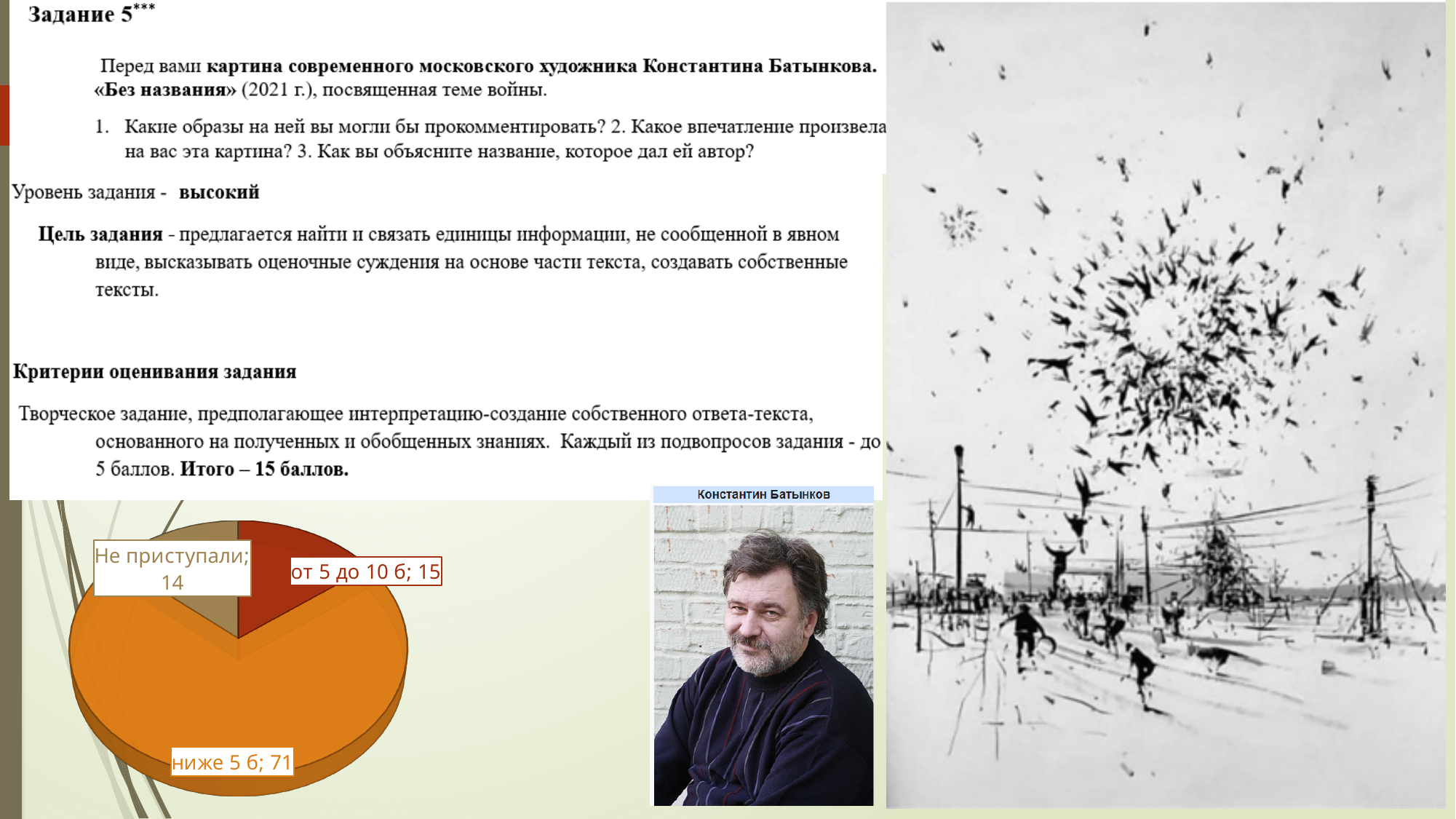
How many slices does the pie chart have? 3 What is the total of all slices in the pie chart? 100 Which slice of the pie chart has the smallest value? Не приступали What kind of chart is shown at the bottom left of the slide? pie chart What colour is the "ниже 5 б" slice in the pie chart? orange What is the value for the slice labelled "от 5 до 10 б" in the pie chart? 15 What is the value for the slice labelled "ниже 5 б" in the pie chart? 71 What share of the pie chart does the "ниже 5 б" slice represent? 71% What is the value for the slice labelled "Не приступали" in the pie chart? 14 Which slice of the pie chart has the largest value? ниже 5 б What is the difference between the values for "от 5 до 10 б" and "Не приступали" in the pie chart? 1 What is the difference between the values for "ниже 5 б" and "от 5 до 10 б" in the pie chart? 56